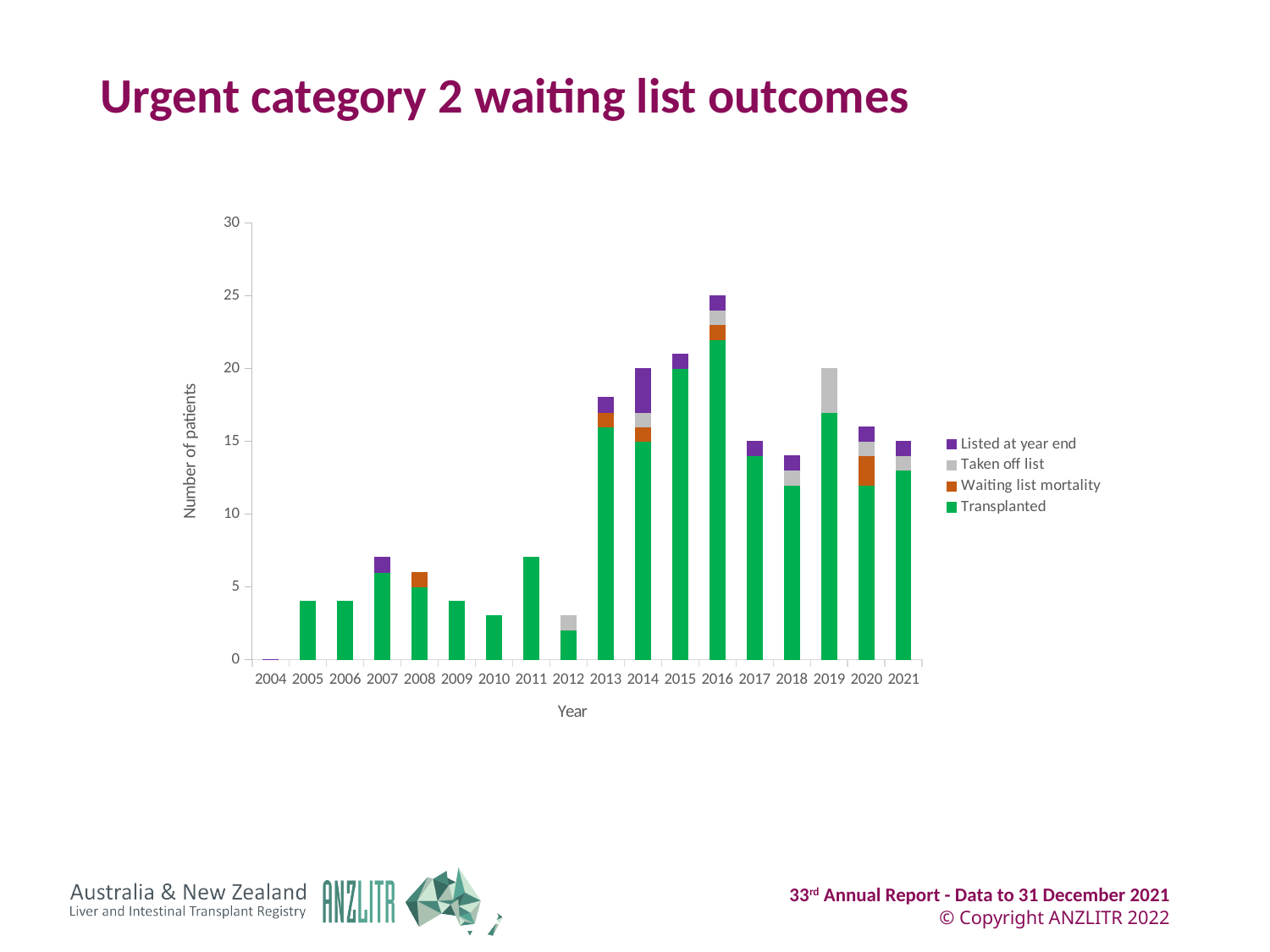
What kind of chart is shown on the slide? stacked bar chart What is the total height of the stacked bar for 2019? 20 Which series is shown in green? Transplanted Is the total for 2013 greater or less than 15? greater Is the Transplanted value for 2018 greater or less than 15? less Which year has the lowest total number of patients? 2004 How many series does the legend list? 4 How many years are shown on the x axis? 18 Do the totals rise or fall from 2016 to 2018? fall What is the total height of the stacked bar for 2016? 25 Which year has a larger total bar, 2015 or 2017? 2015 Which year has the tallest stacked bar? 2016